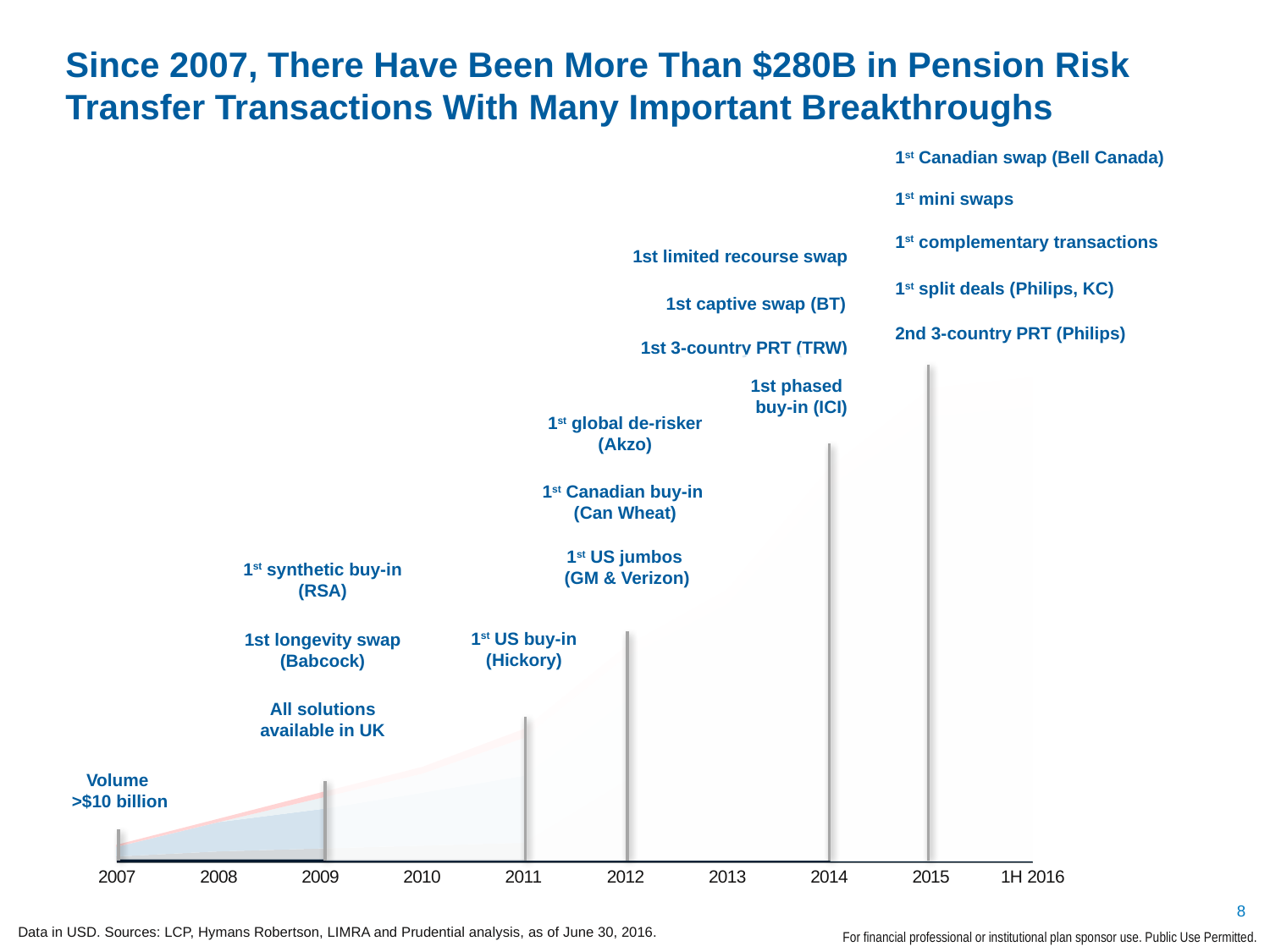
Which year has the shortest vertical marker line on the chart? 2007 What is the last label on the x axis of the chart? 1H 2016 Does the plotted volume rise or fall from 2007 to 1H 2016? Rise How many year labels are shown along the x axis of the chart? 10 What is the first year label on the x axis of the chart? 2007 Which year has the tallest vertical marker line on the chart? 2015 Is the vertical marker line at 2009 taller or shorter than the one at 2012? Shorter What kind of chart is shown on the slide? Area chart Which milestone is annotated as the 1st Canadian swap on the chart? Bell Canada Is the vertical marker line at 2014 taller or shorter than the one at 2011? Taller What volume is labeled at the 2007 point of the chart? >$10 billion According to the slide title, how much in pension risk transfer transactions has there been since 2007? More than $280B